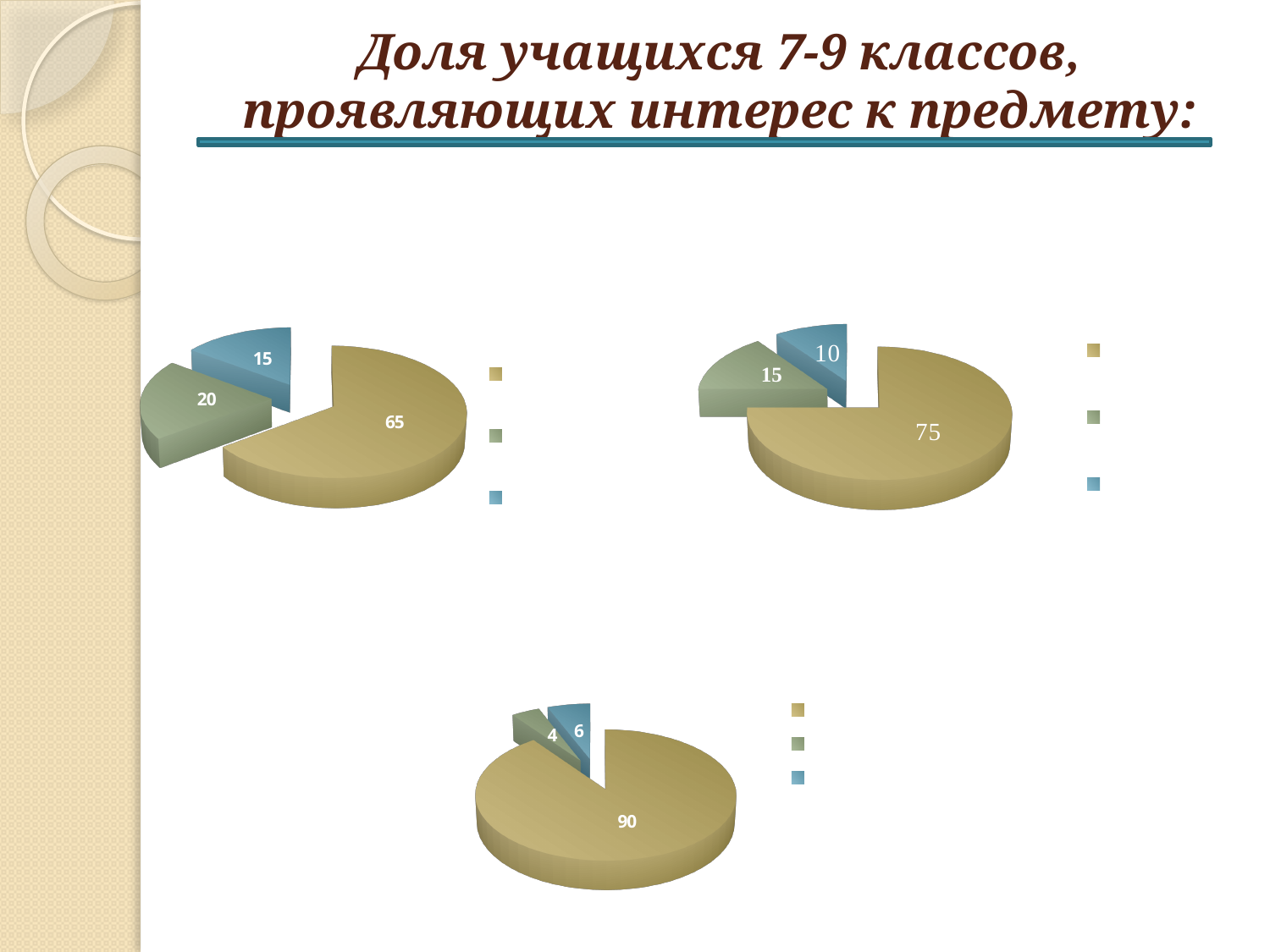
In the top-left pie chart, what is the value of the green slice? 20 In the top-left pie chart, what is the value of the largest (tan) slice? 65 In the top-left pie chart, what is the difference between the tan slice and the green slice? 45 In the top-left pie chart, what is the value of the blue slice? 15 In the top-right pie chart, what is the value of the blue slice? 10 In the top-right pie chart, what is the total of all three slices? 100 How many slices does each pie chart have? 3 In the bottom pie chart, what is the smallest value shown? 4 In the bottom pie chart, what is the value of the largest (tan) slice? 90 What type of charts are shown on the slide? Pie charts How many pie charts are on the slide? 3 In the top-right pie chart, what is the value of the largest (tan) slice? 75